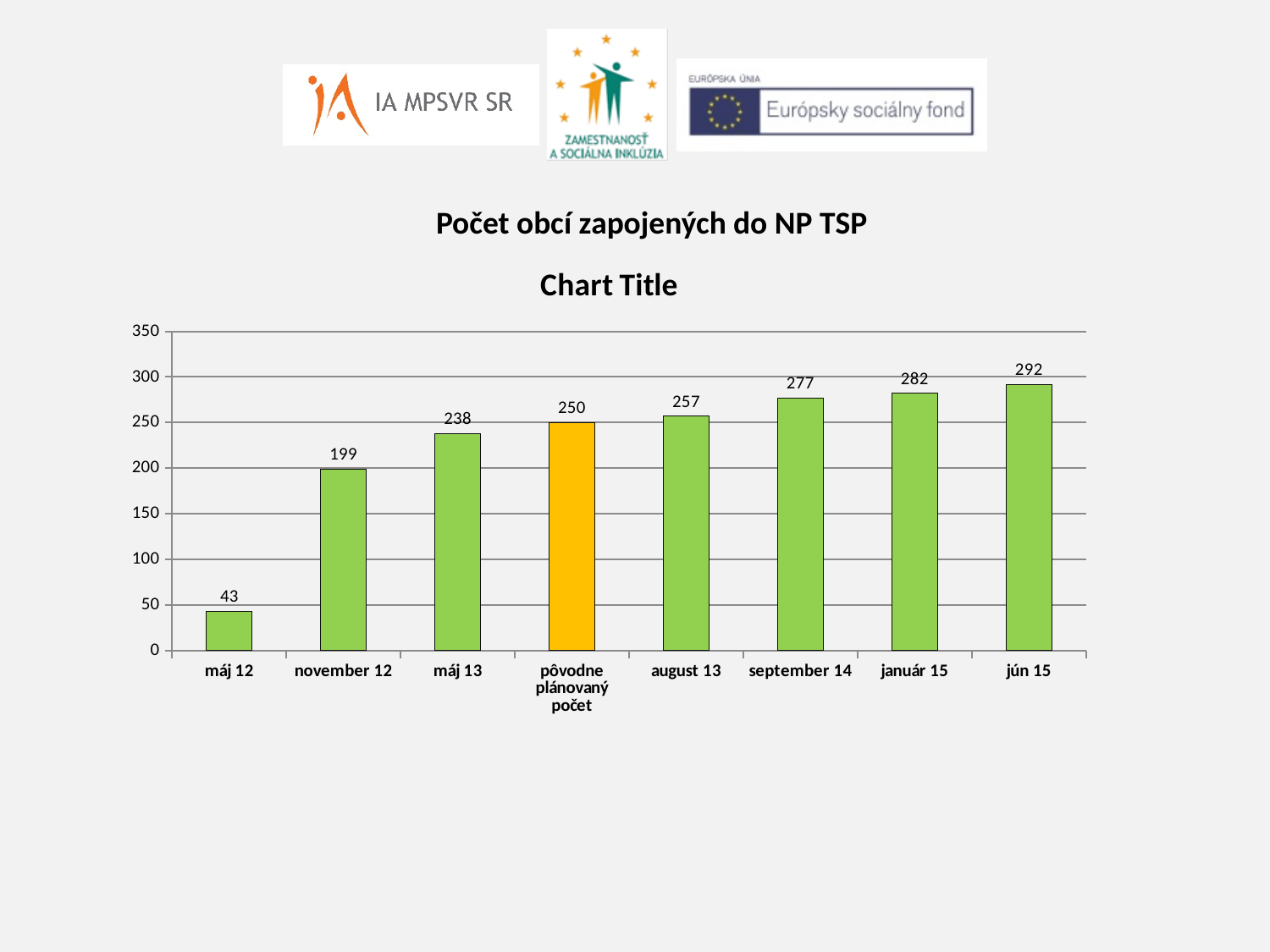
What is the value for pôvodne plánovaný počet? 250 What is the difference between the values for jún 15 and pôvodne plánovaný počet? 42 Which category has the lowest value? máj 12 How many categories are shown on the x axis? 8 Which is larger, the value for máj 13 or the value for august 13? august 13 What kind of chart is shown on the slide? bar chart What is the difference between the values for november 12 and máj 12? 156 Is the value for január 15 greater or less than 300? less What is the value for máj 12? 43 What is the value for september 14? 277 Which bar is coloured differently (orange) from the others? pôvodne plánovaný počet Which category has the highest value? jún 15